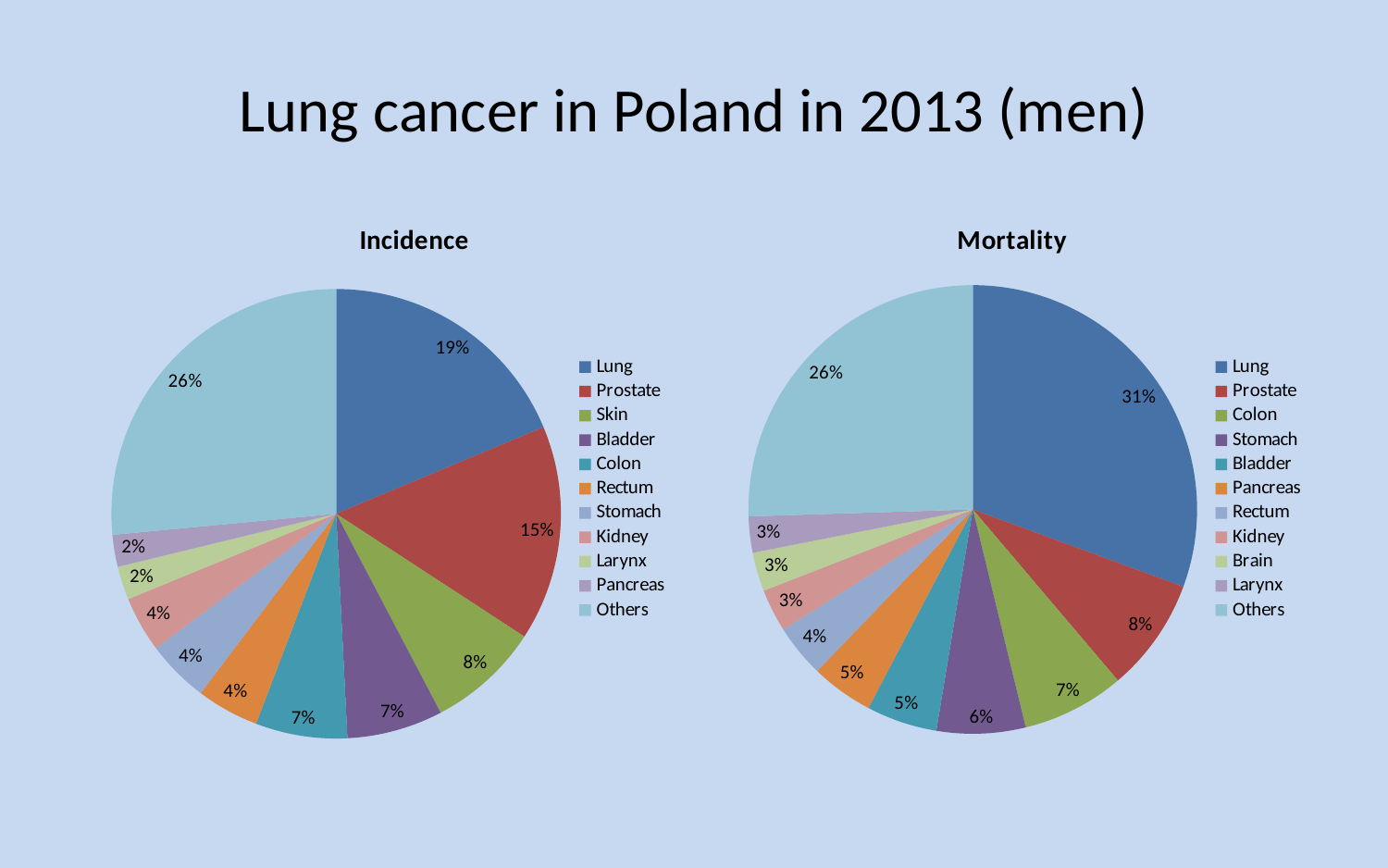
In the Mortality chart, which category has the largest slice? Lung In the Incidence chart, what is the value for Prostate? 15% In the Incidence chart, what is the difference between the Prostate share and the Colon share? 8% What is the title of the slide? Lung cancer in Poland in 2013 (men) In the Incidence chart, what share does Lung account for? 19% In the Incidence chart, which is larger, the Prostate slice or the Skin slice? Prostate What kind of chart is the Incidence chart? Pie chart In the Mortality chart, what share does Lung account for? 31% In the Incidence chart, which named cancer type (excluding Others) has the largest slice? Lung What is the difference between the Lung share in the Mortality chart and the Lung share in the Incidence chart? 12% In the Mortality chart, what is the value for Stomach? 6% How many categories does the legend of the Mortality chart list? 11